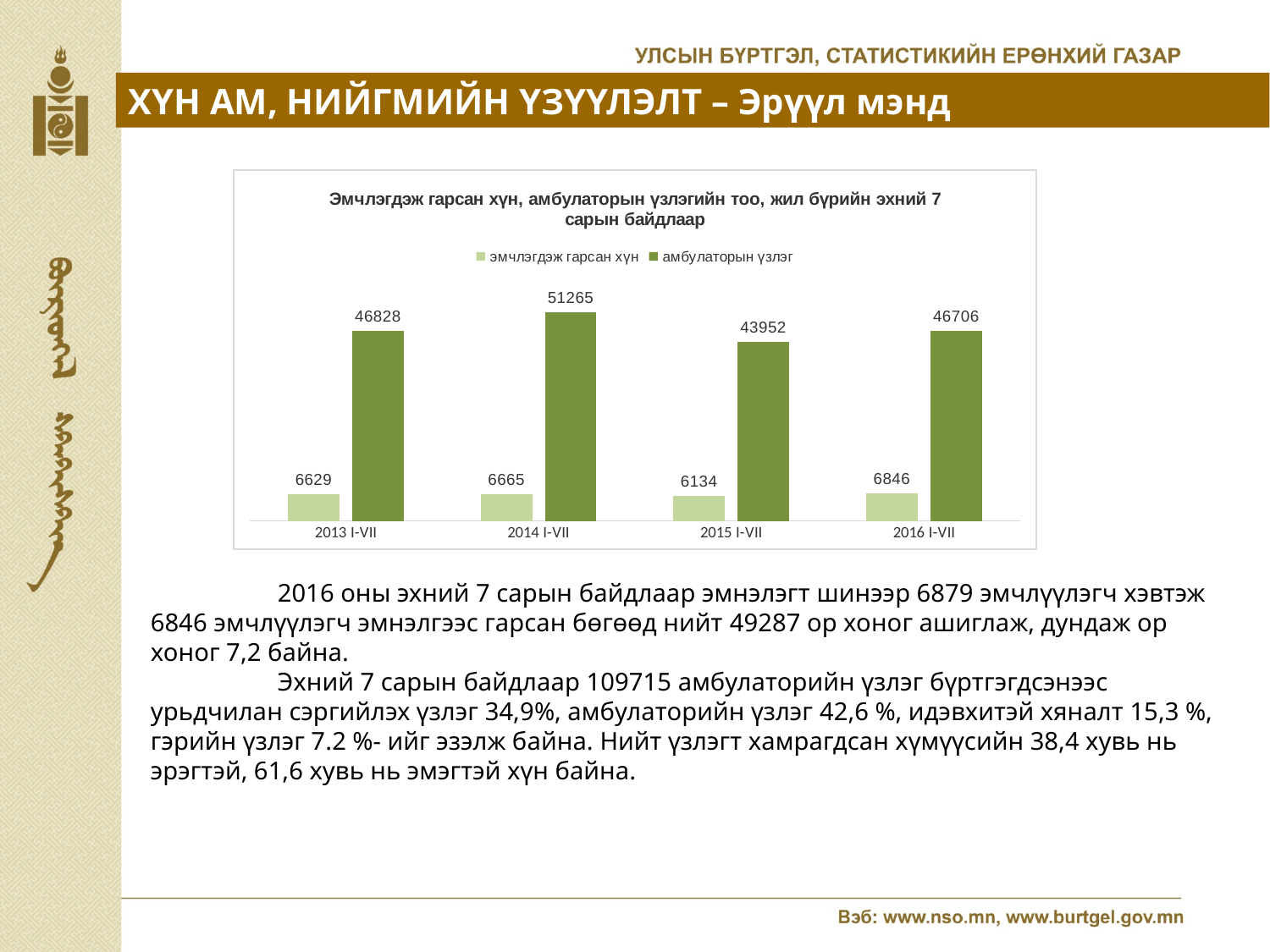
What is the value for эмчлэгдэж гарсан хүн in 2015 I-VII? 6134 What is the difference between амбулаторын үзлэг in 2014 I-VII and 2015 I-VII? 7313 What is the difference between эмчлэгдэж гарсан хүн in 2016 I-VII and 2013 I-VII? 217 In which period is амбулаторын үзлэг highest? 2014 I-VII What is the value for амбулаторын үзлэг in 2014 I-VII? 51265 How many series does the legend list? 2 Which series is shown in the darker green colour? амбулаторын үзлэг Which is larger: амбулаторын үзлэг in 2013 I-VII or in 2016 I-VII? 2013 I-VII How many periods are shown on the x axis? 4 What kind of chart is shown on the slide? bar chart What is the value for эмчлэгдэж гарсан хүн in 2016 I-VII? 6846 In which period is эмчлэгдэж гарсан хүн lowest? 2015 I-VII